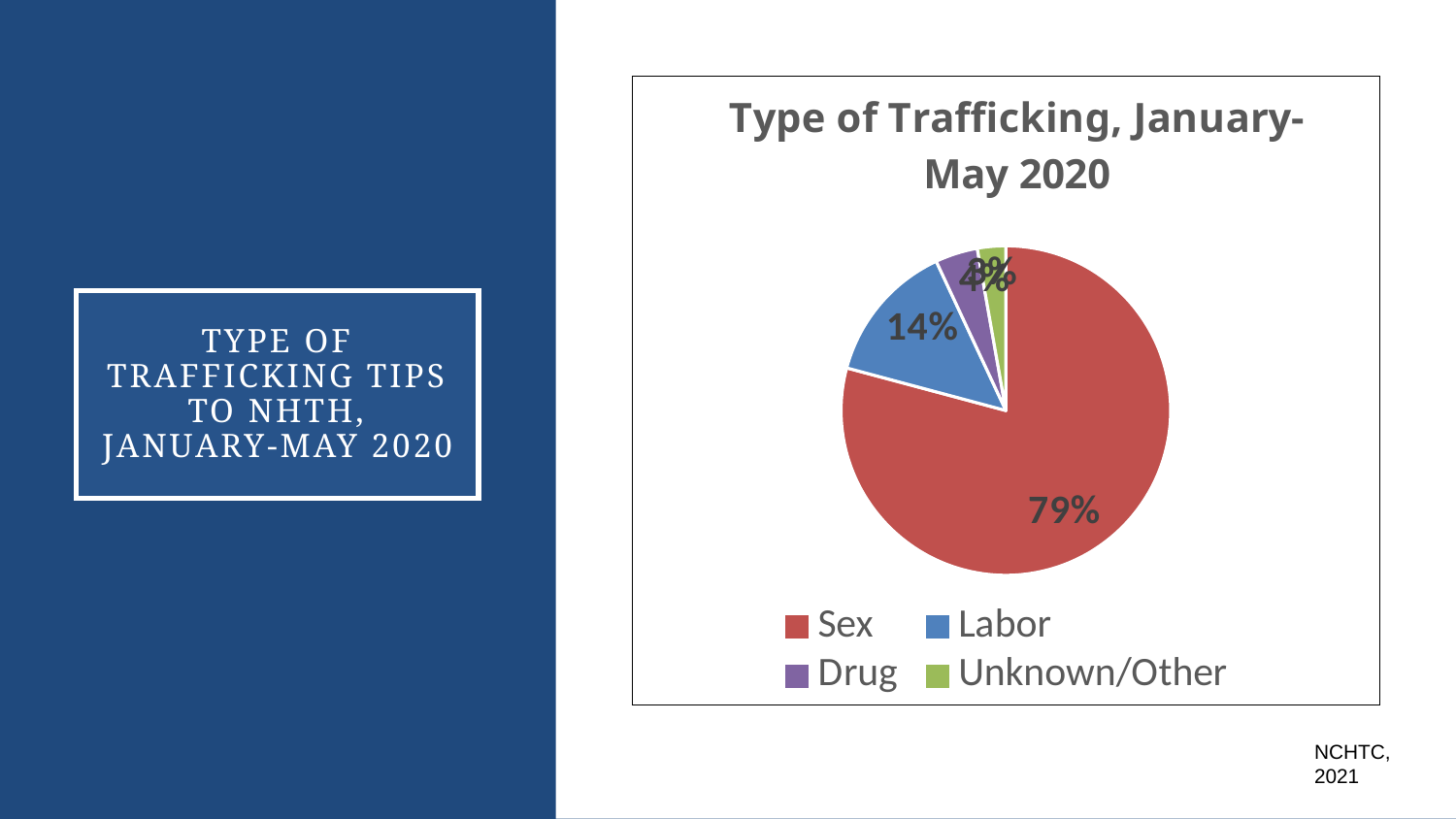
What is the difference in percentage points between the Sex share and the Labor share? 65 Is the share for Labor greater or less than the share for Drug? greater What share of the pie does Labor trafficking account for? 14% What share of the pie does Sex trafficking account for? 79% What is the title of the chart? Type of Trafficking, January-May 2020 How many categories does the legend list? 4 Which category is shown in blue in the legend? Labor Which is larger, the share for Sex or the share for Labor? Sex What type of chart is shown on the slide? pie chart Which type of trafficking has the largest share of the pie? Sex